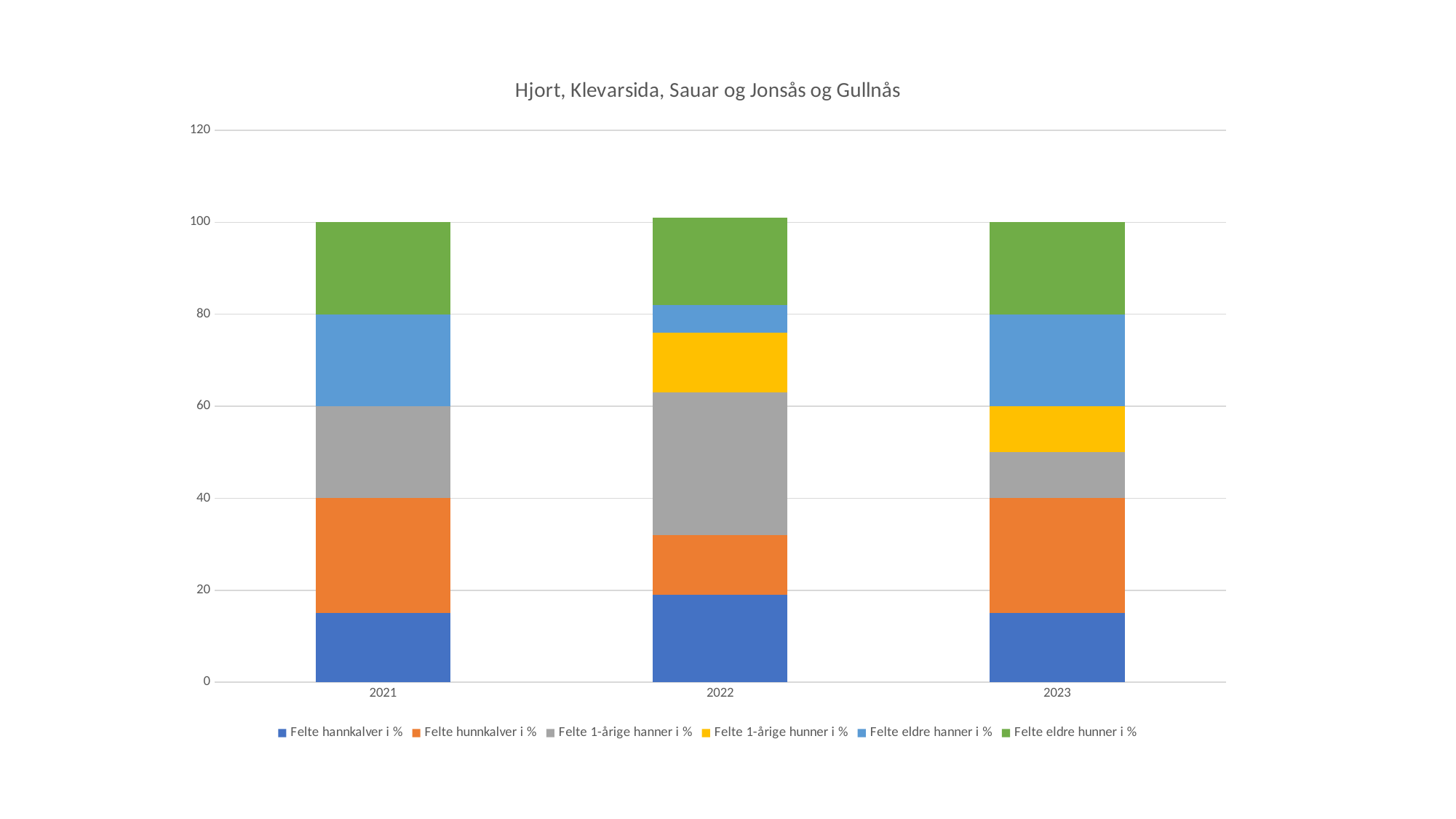
Which year has the largest Felte 1-årige hanner i % segment? 2022 Is the value for Felte 1-årige hanner i % in 2022 greater or less than 20? greater How many years are shown on the x axis of the chart? 3 Which colour represents Felte 1-årige hunner i % in the chart? Yellow Which year has the smallest Felte eldre hanner i % segment? 2022 What kind of chart is shown on the slide? Stacked bar chart Which is larger, the Felte 1-årige hanner i % segment in 2022 or in 2023? 2022 What is the title of the chart? Hjort, Klevarsida, Sauar og Jonsås og Gullnås How many series does the legend list? 6 What is the total height of the stacked bar for 2021? 100 Is the value for Felte hannkalver i % in 2021 greater or less than 20? less Is the value for Felte eldre hanner i % in 2022 greater or less than 20? less